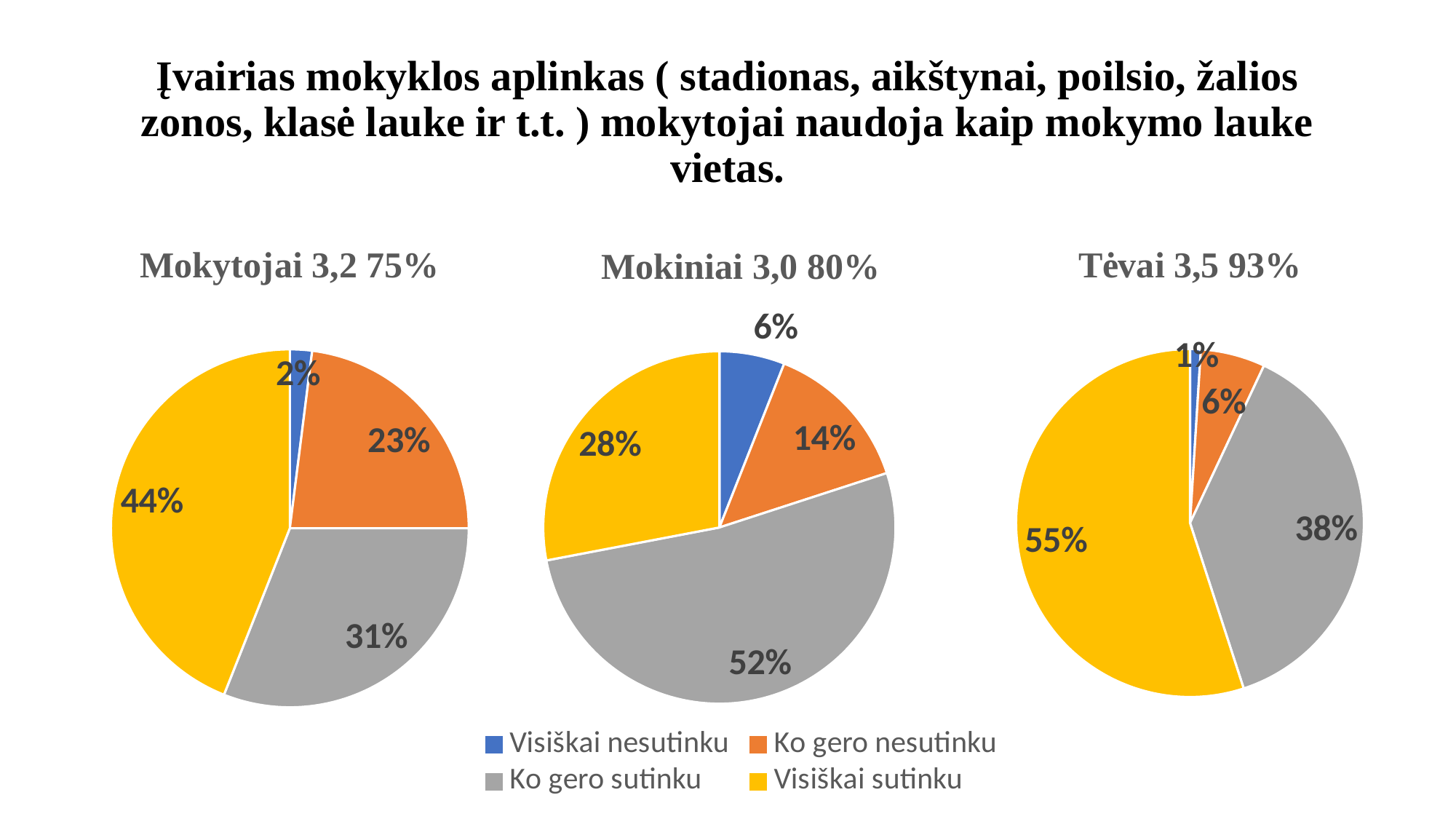
What kind of chart is used for 'Mokiniai 3,0 80%'? Pie chart In the 'Mokytojai 3,2 75%' pie chart, what is the difference between 'Visiškai sutinku' and 'Ko gero sutinku'? 13% In the 'Tėvai 3,5 93%' pie chart, which category has the largest slice? Visiškai sutinku Which colour represents 'Ko gero sutinku' in the legend? Grey In the 'Tėvai 3,5 93%' pie chart, what share is 'Ko gero nesutinku'? 6% In the 'Mokiniai 3,0 80%' pie chart, which category has the smallest slice? Visiškai nesutinku In the 'Mokytojai 3,2 75%' pie chart, what share is 'Visiškai sutinku'? 44% In the 'Mokytojai 3,2 75%' pie chart, which category has the largest slice? Visiškai sutinku How many series does the legend list? 4 In the 'Mokiniai 3,0 80%' pie chart, what share is 'Ko gero sutinku'? 52% In the 'Tėvai 3,5 93%' pie chart, what share is 'Visiškai nesutinku'? 1% In the 'Mokiniai 3,0 80%' pie chart, which is larger: 'Ko gero sutinku' or 'Visiškai sutinku'? Ko gero sutinku